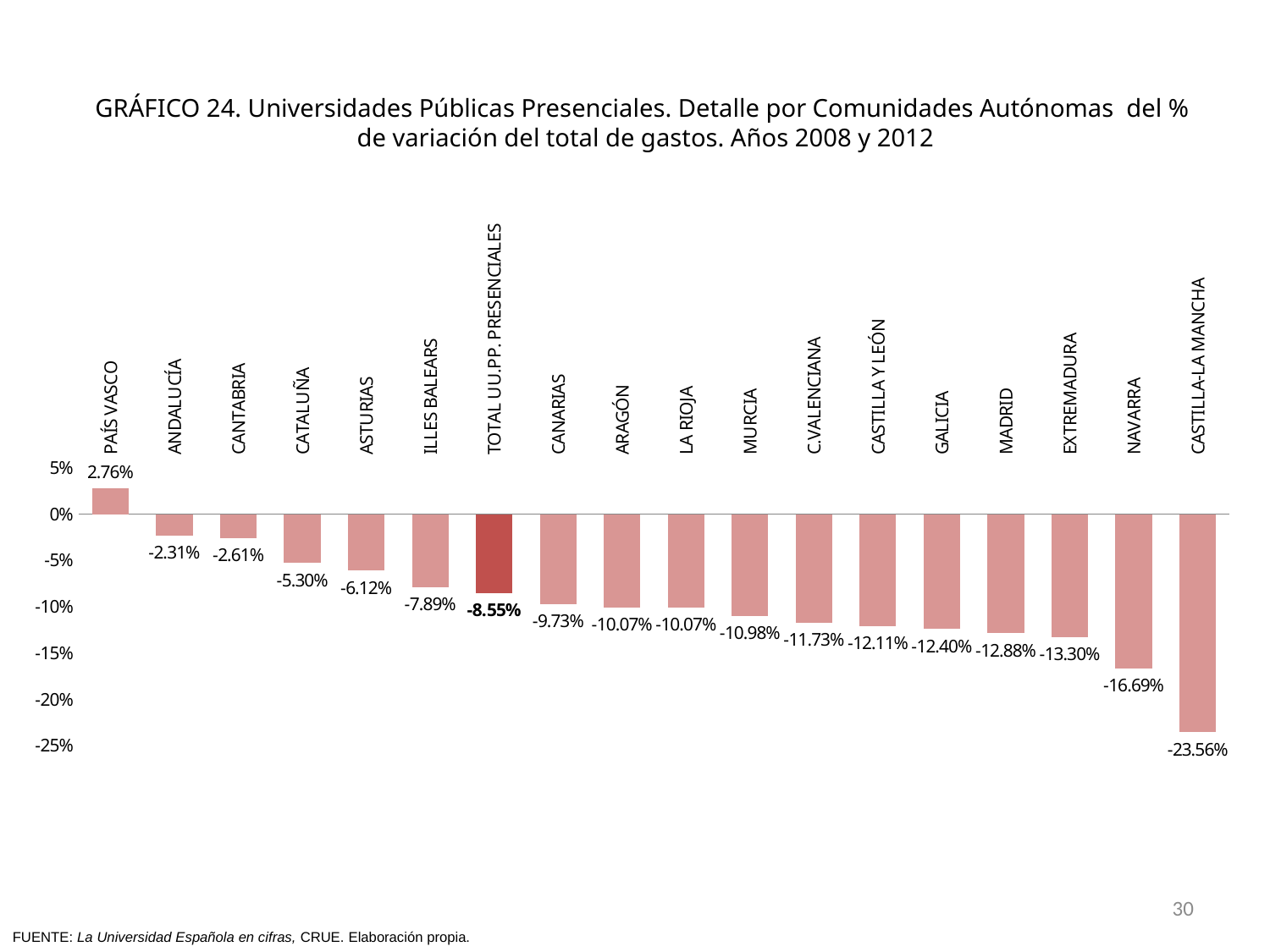
What is the value for NAVARRA? -16.69% What is the value for GALICIA? -12.40% What kind of chart is this? bar chart What is the difference between the values for CASTILLA-LA MANCHA and NAVARRA? 6.87 percentage points How many categories are shown on the x axis? 18 Which community has the lowest value? CASTILLA-LA MANCHA Which has a larger value, CATALUÑA or ASTURIAS? CATALUÑA What is the value for PAÍS VASCO? 2.76% Do the values rise or fall from left to right along the x axis? fall Is the value for MADRID greater or less than -10%? less Which community has the highest value? PAÍS VASCO What is the value for TOTAL UU.PP. PRESENCIALES? -8.55%